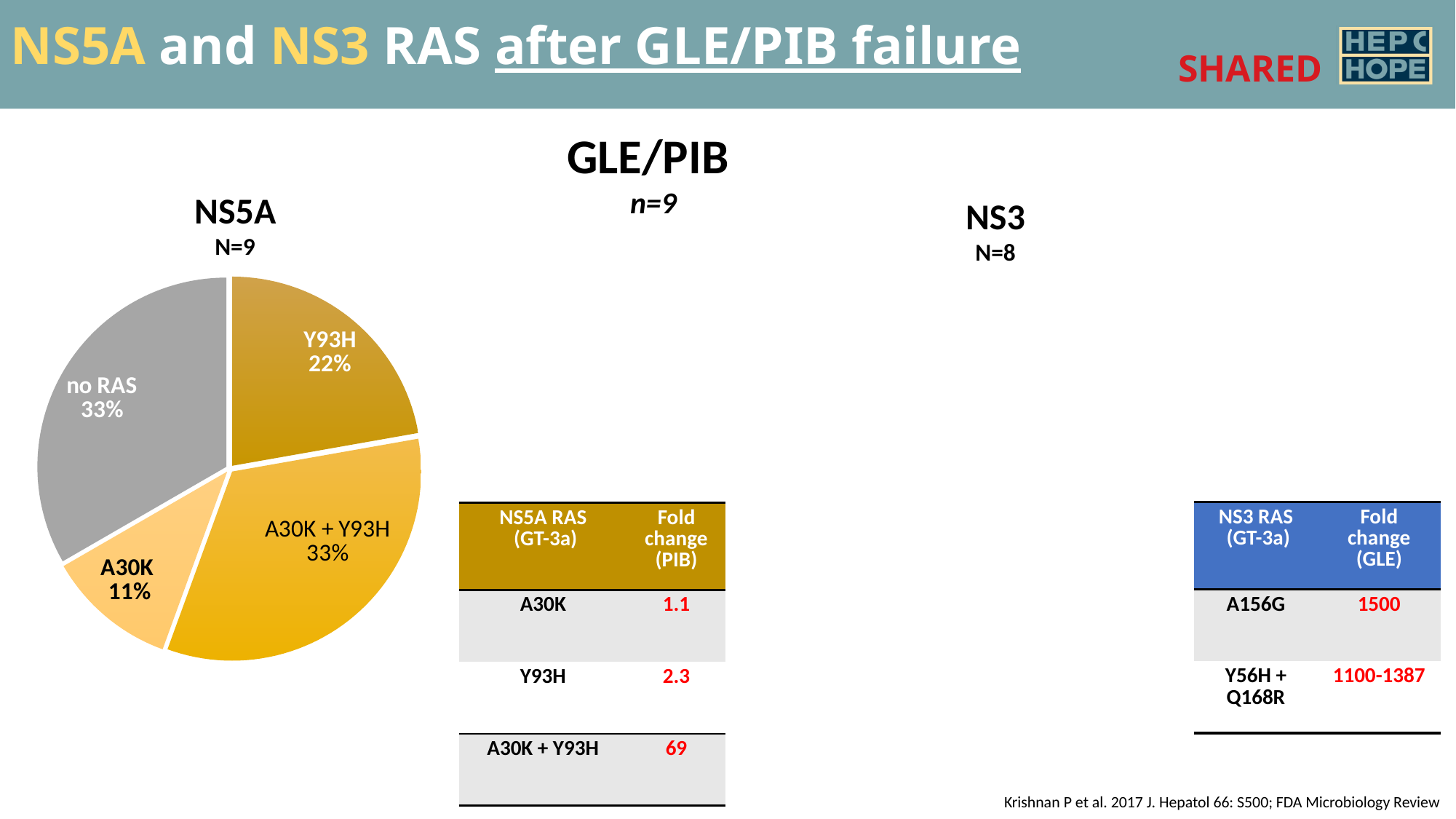
What sample size (N) is shown above the NS5A pie chart? N=9 In the NS5A pie chart, what share is labelled for Y93H? 22% In the NS5A pie chart, what share is labelled for A30K + Y93H? 33% In the NS5A pie chart, what is the difference between the A30K + Y93H share and the Y93H share? 11% In the NS5A pie chart, what share is labelled for no RAS? 33% In the NS5A pie chart, which is larger: the Y93H slice or the A30K slice? Y93H What kind of chart is the NS5A chart on the slide? pie chart In the NS5A pie chart, what is the difference between the no RAS share and the A30K share? 22% What colour is the no RAS slice in the NS5A pie chart? grey How many slices does the NS5A pie chart have? 4 Which slice of the NS5A pie chart is the smallest? A30K